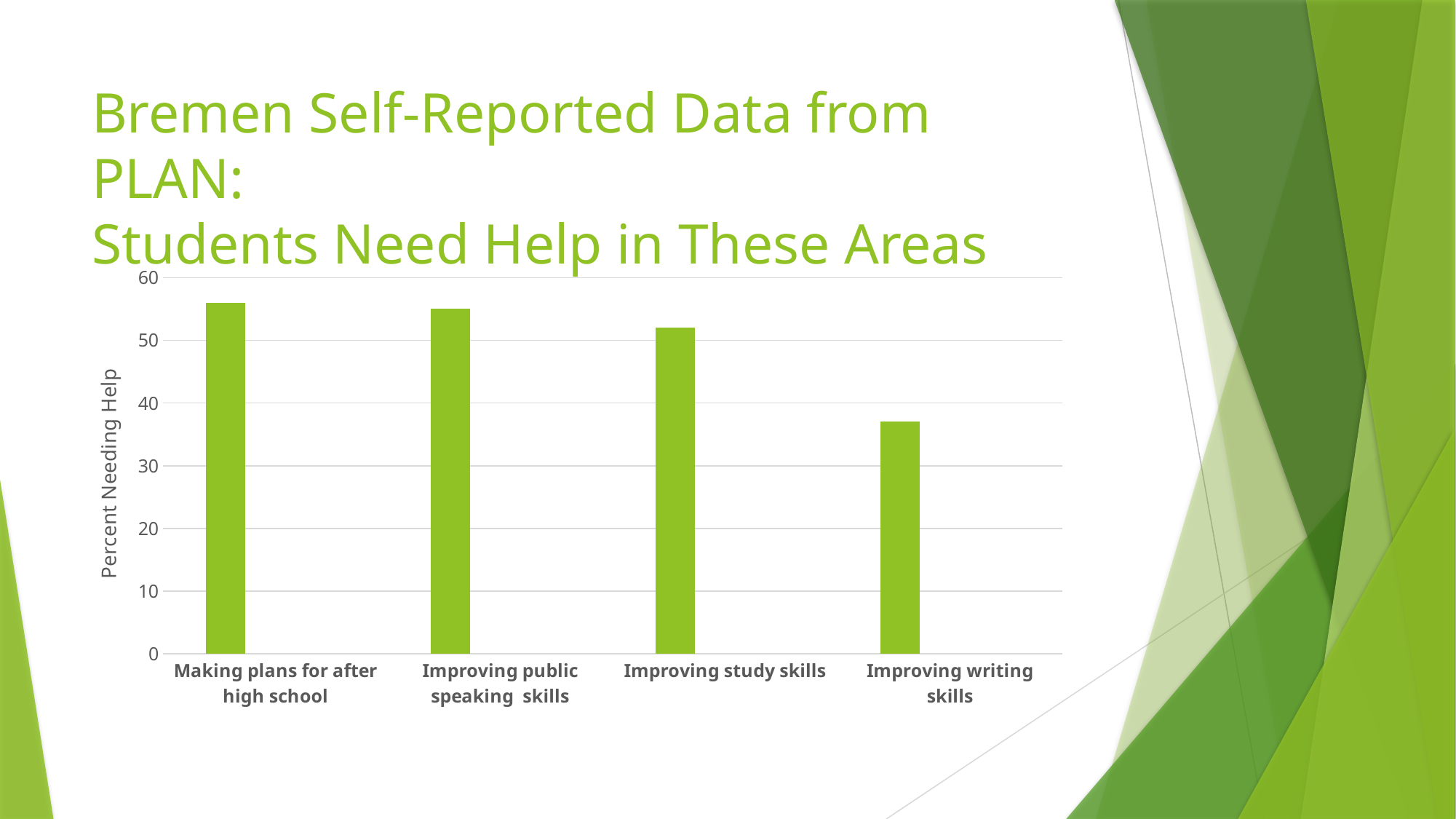
What is the label on the vertical axis of the chart? Percent Needing Help Is the value for Improving writing skills greater or less than 30? greater Is the value for Improving study skills greater or less than 50? greater Is the value for Improving writing skills greater or less than 40? less Which is larger, the value for Improving study skills or the value for Improving writing skills? Improving study skills Which category has the lowest percent needing help? Improving writing skills Which is larger, the value for Making plans for after high school or the value for Improving study skills? Making plans for after high school Do the values rise or fall from left to right across the categories? fall How many categories are shown in the chart? 4 What kind of chart is shown on the slide? bar chart